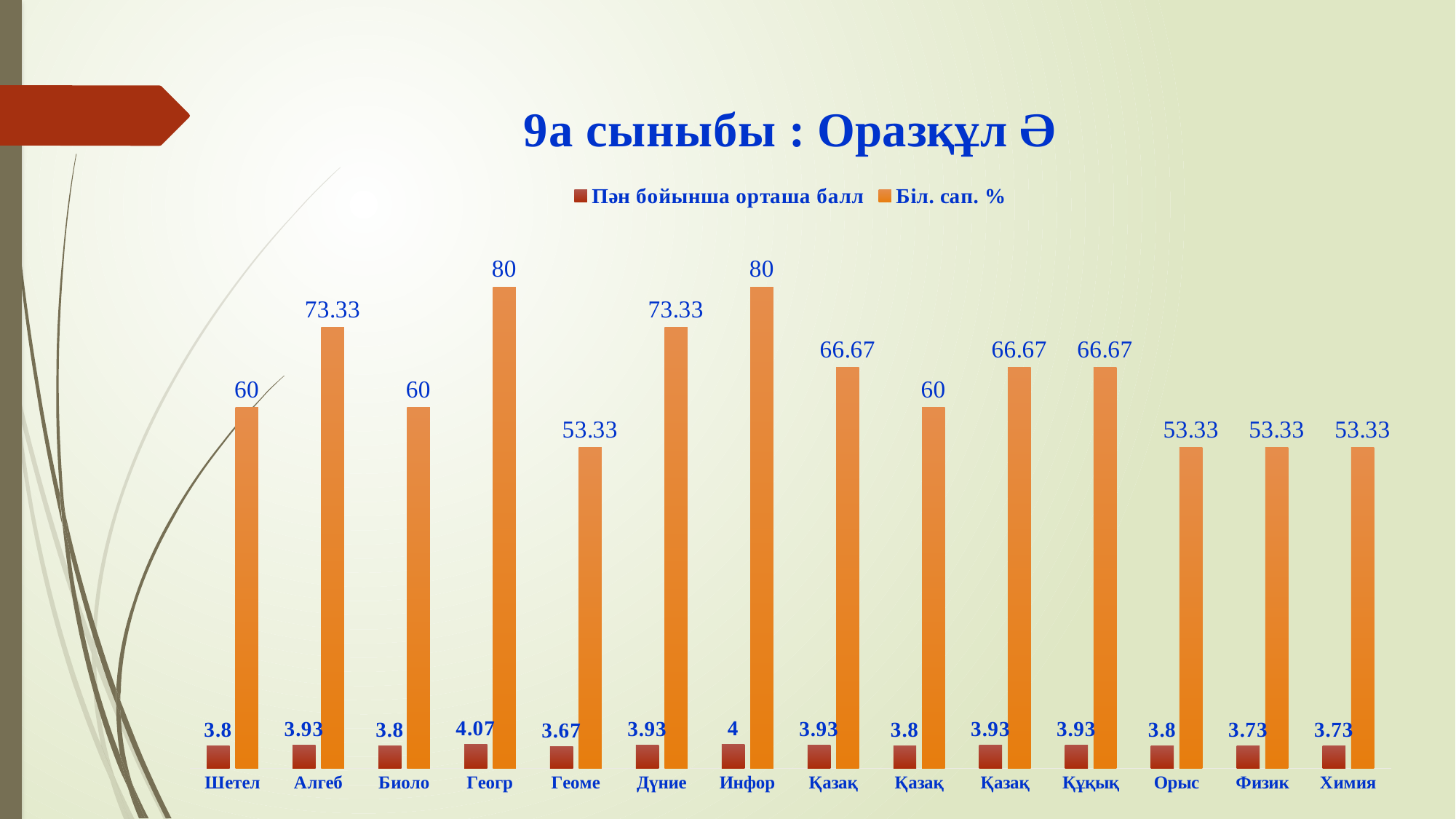
How many series does the legend list? 2 Which category has the highest Пән бойынша орташа балл? Геогр Which category has the lowest Пән бойынша орташа балл? Геоме How many categories are shown on the x axis? 14 What kind of chart is shown on the slide? bar chart What is the value of Пән бойынша орташа балл for Геоме? 3.67 What is the value of Пән бойынша орташа балл for Құқық? 3.93 What is the difference in Біл. сап. % between Геогр and Шетел? 20 What is the difference in Пән бойынша орташа балл between Инфор and Физик? 0.27 Which has a higher Біл. сап. %, Дүние or Орыс? Дүние What is the value of Біл. сап. % for Химия? 53.33 What is the value of Біл. сап. % for Алгеб? 73.33